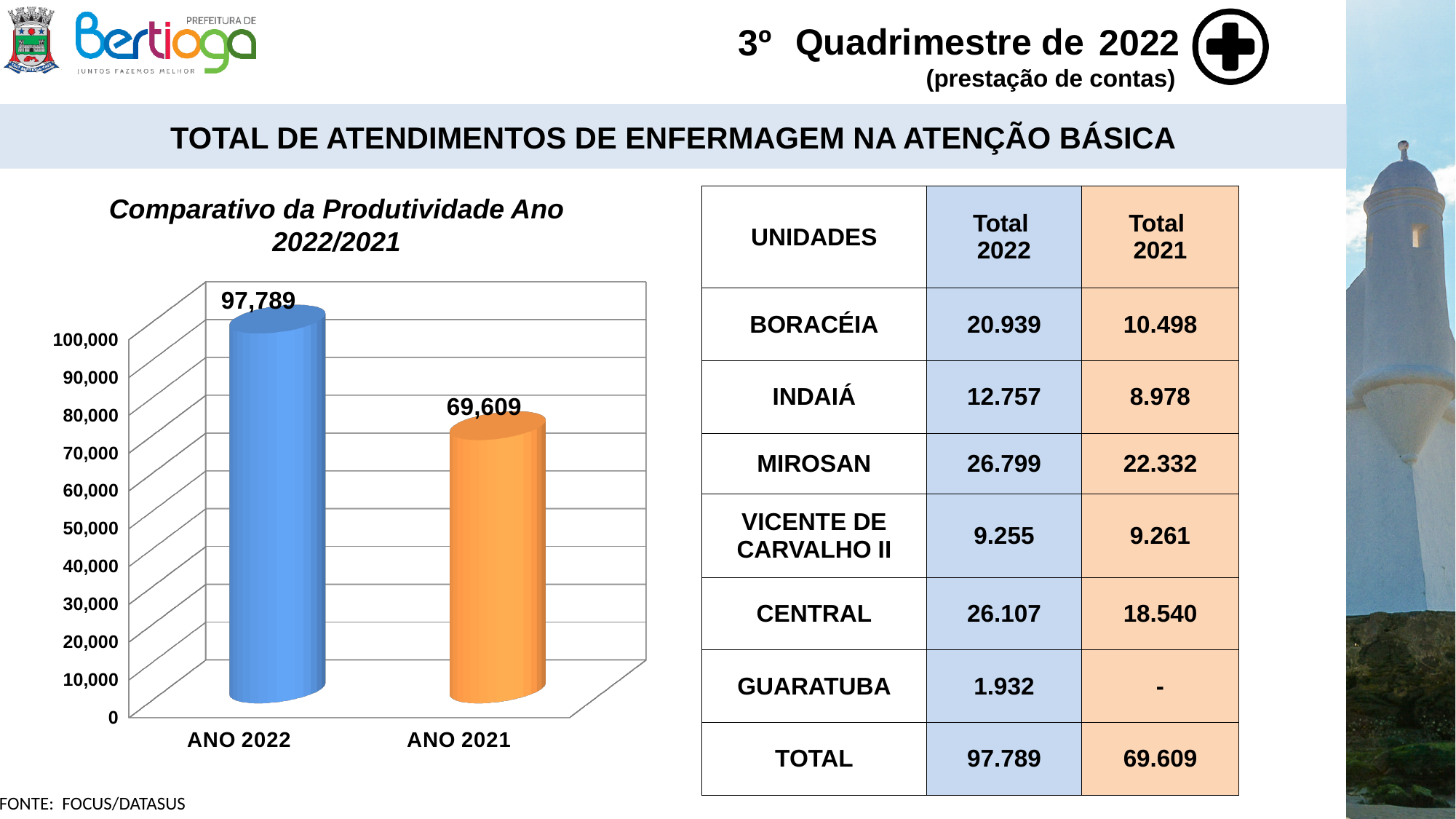
What kind of chart is shown on the slide? bar chart How many categories are plotted in the chart? 2 Do the values rise or fall from ANO 2022 to ANO 2021 along the x axis? fall Which is larger in the chart, the value for ANO 2022 or the value for ANO 2021? ANO 2022 What is the difference between the values for ANO 2022 and ANO 2021 in the chart? 28,180 Which category has the highest value in the chart? ANO 2022 Which category has the lowest value in the chart? ANO 2021 What is the value for ANO 2021 in the chart? 69,609 What is the title of the chart? Comparativo da Produtividade Ano 2022/2021 Is the value for ANO 2021 greater or less than 80,000? less What is the value for ANO 2022 in the chart? 97,789 Is the value for ANO 2022 greater or less than 90,000? greater